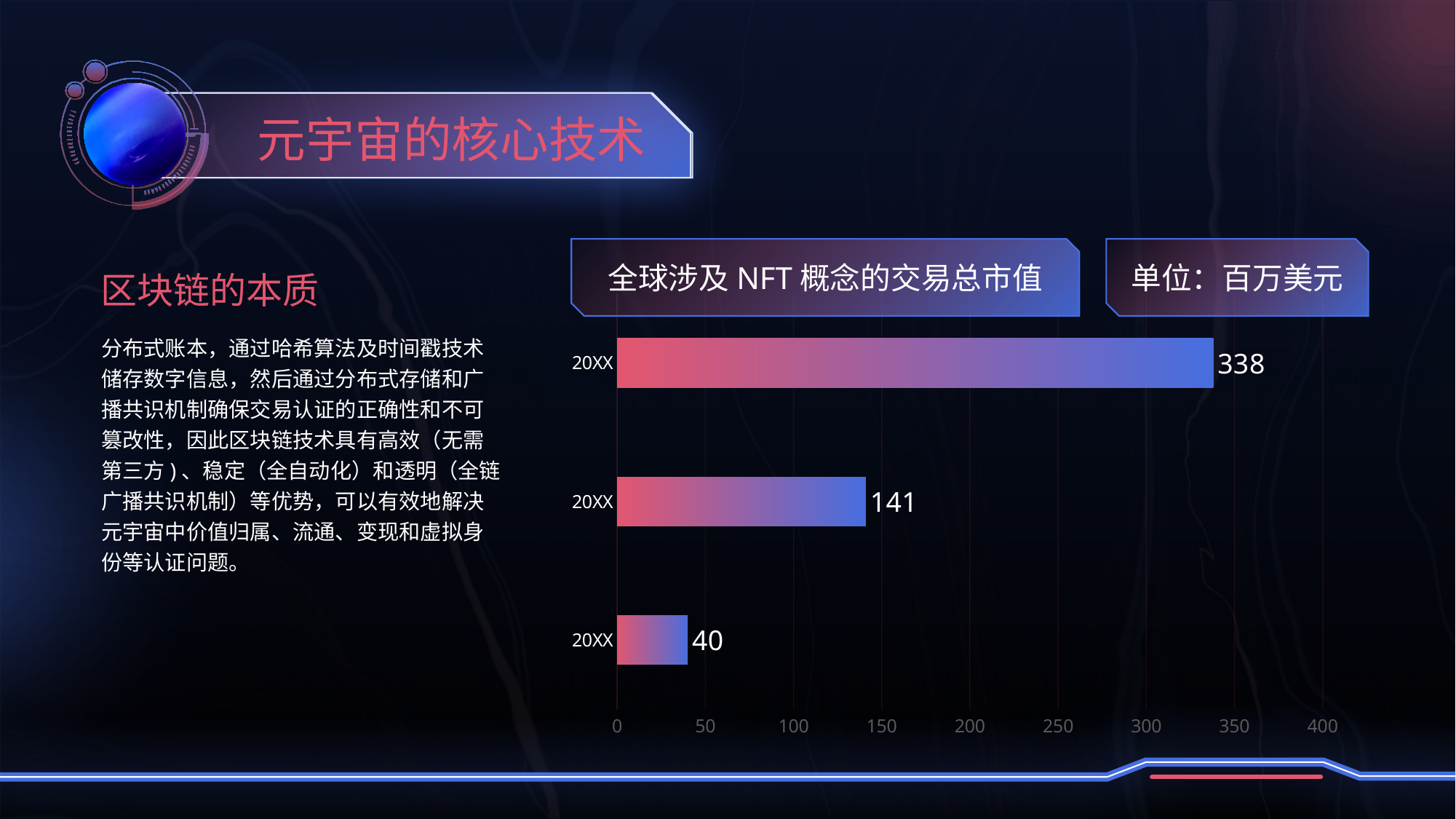
What is the difference between the middle bar's value and the bottom bar's value? 101 What is the difference between the top bar's value and the middle bar's value? 197 What is the highest value shown in the chart? 338 What unit is stated for the chart's values? 百万美元 What is the lowest value shown in the chart? 40 Which bar is larger, the middle bar or the bottom bar? the middle bar What is the value of the middle bar in the chart? 141 What is the value of the top bar in the chart? 338 Is the value of the top bar greater or less than 300? greater What is the value of the bottom bar in the chart? 40 How many bars are plotted in the chart? 3 What kind of chart is shown on the slide? bar chart